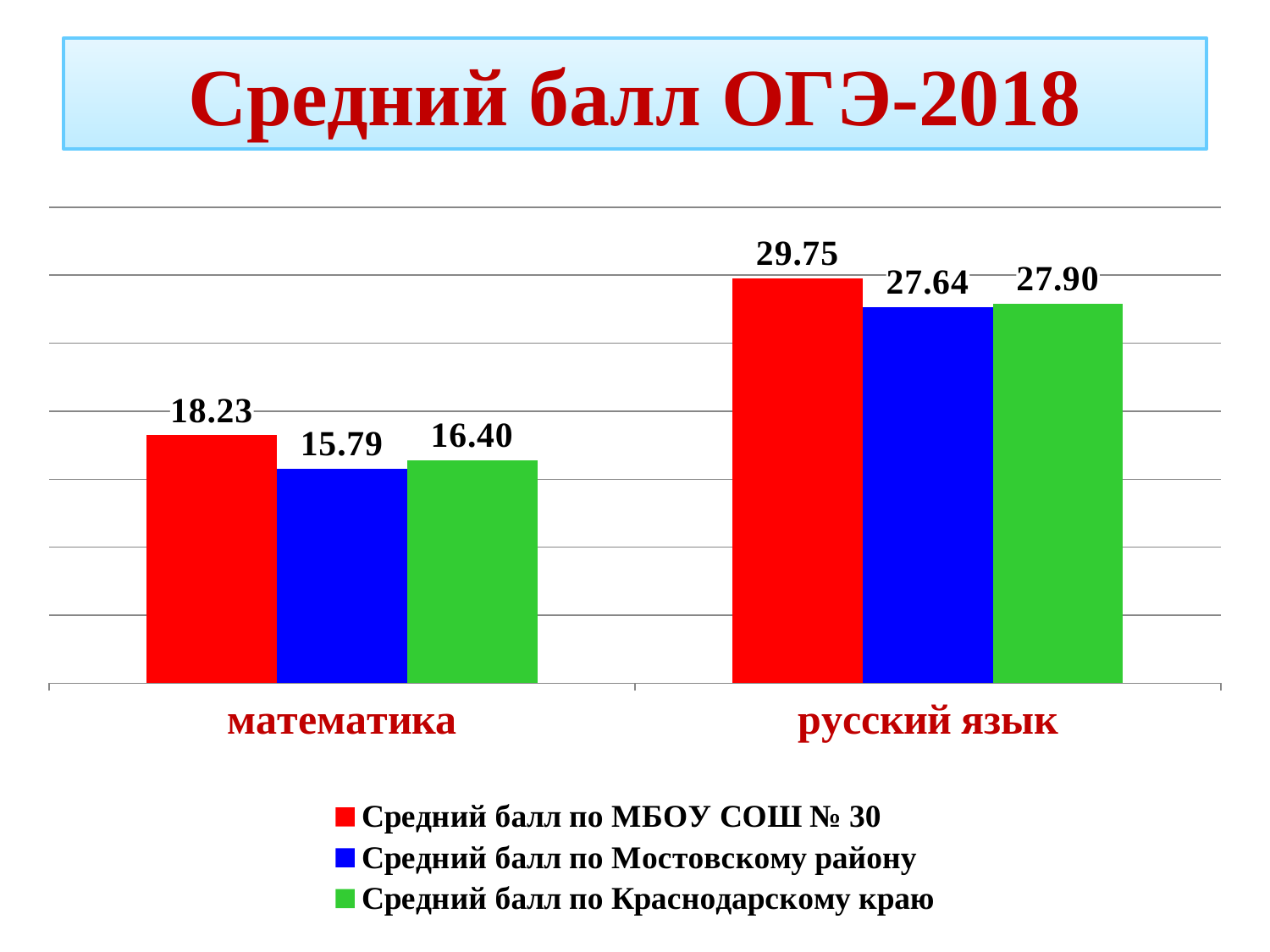
What is the average score for русский язык for Мостовский район? 27.64 What is the difference between the МБОУ СОШ № 30 score and the Краснодарский край score for русский язык? 1.85 How many subject categories are shown on the x axis? 2 What is the average score for математика for МБОУ СОШ № 30? 18.23 What is the average score for русский язык for Краснодарский край? 27.90 Which is larger: the Краснодарский край score for математика or the Мостовский район score for математика? Краснодарский край (16.40) What is the difference between the МБОУ СОШ № 30 score and the Мостовский район score for математика? 2.44 Which series has the highest value for русский язык? Средний балл по МБОУ СОШ № 30 Which series has the lowest value for математика? Средний балл по Мостовскому району What is the average score for математика for Краснодарский край? 16.40 What kind of chart is shown on the slide? Bar chart How many series does the legend list? 3